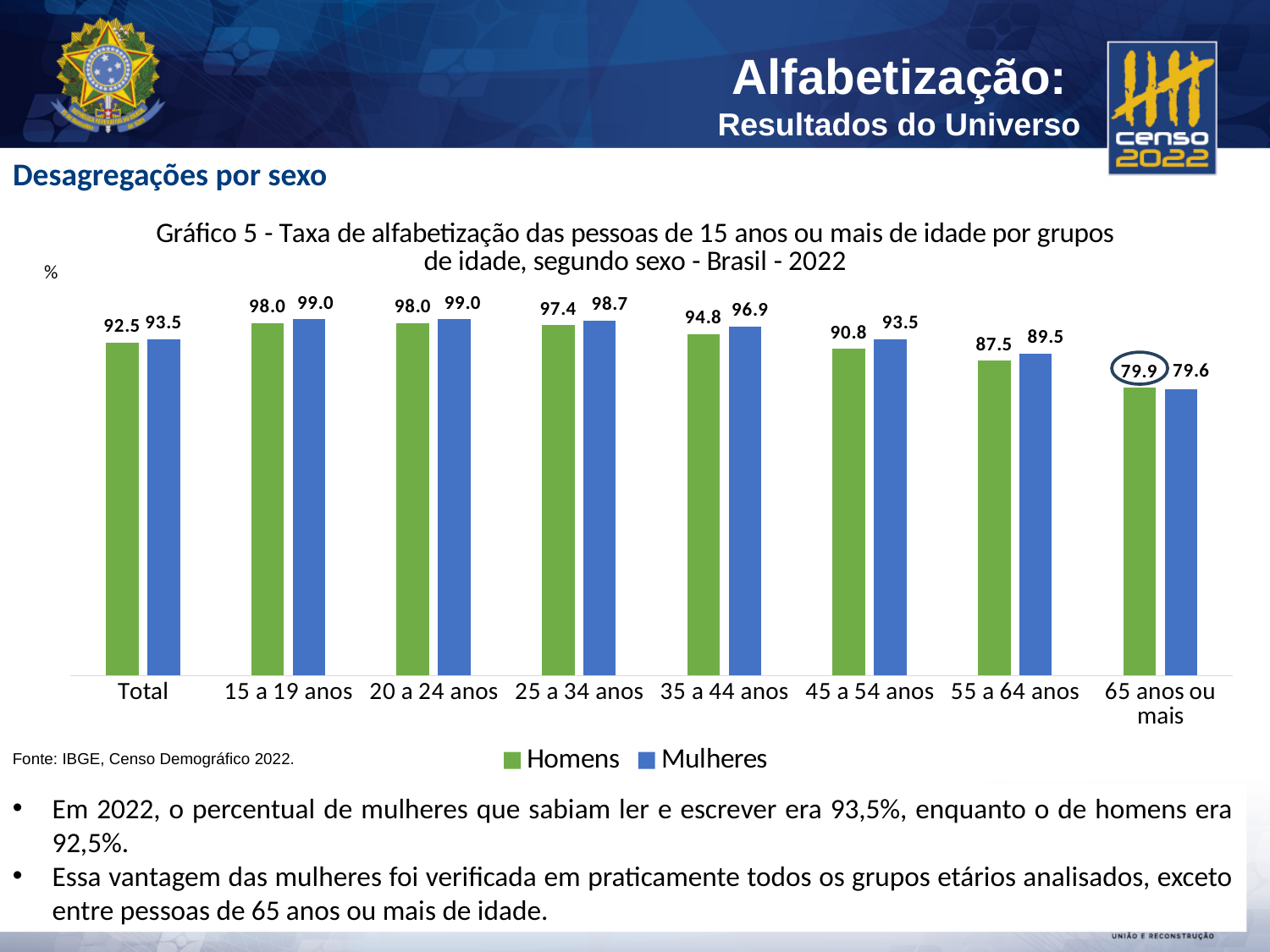
How many age-group categories (including Total) are shown on the x axis? 8 In the '35 a 44 anos' group, which series has the higher literacy rate, Homens or Mulheres? Mulheres Which age group has the highest literacy rate for Mulheres? 15 a 19 anos and 20 a 24 anos (both 99.0) How many series does the legend list? 2 Which age group has the lowest literacy rate for Homens? 65 anos ou mais What is the literacy rate for Mulheres in the '65 anos ou mais' group? 79.6 What is the literacy rate for Mulheres in the '45 a 54 anos' group? 93.5 In the '65 anos ou mais' group, which series has the higher literacy rate, Homens or Mulheres? Homens What is the difference between the Mulheres and Homens literacy rates in the '55 a 64 anos' group? 2.0 What is the literacy rate for Homens in the 'Total' category? 92.5 Moving from '15 a 19 anos' to '65 anos ou mais', do the Homens literacy rates rise or fall? Fall What kind of chart is shown on the slide? Bar chart